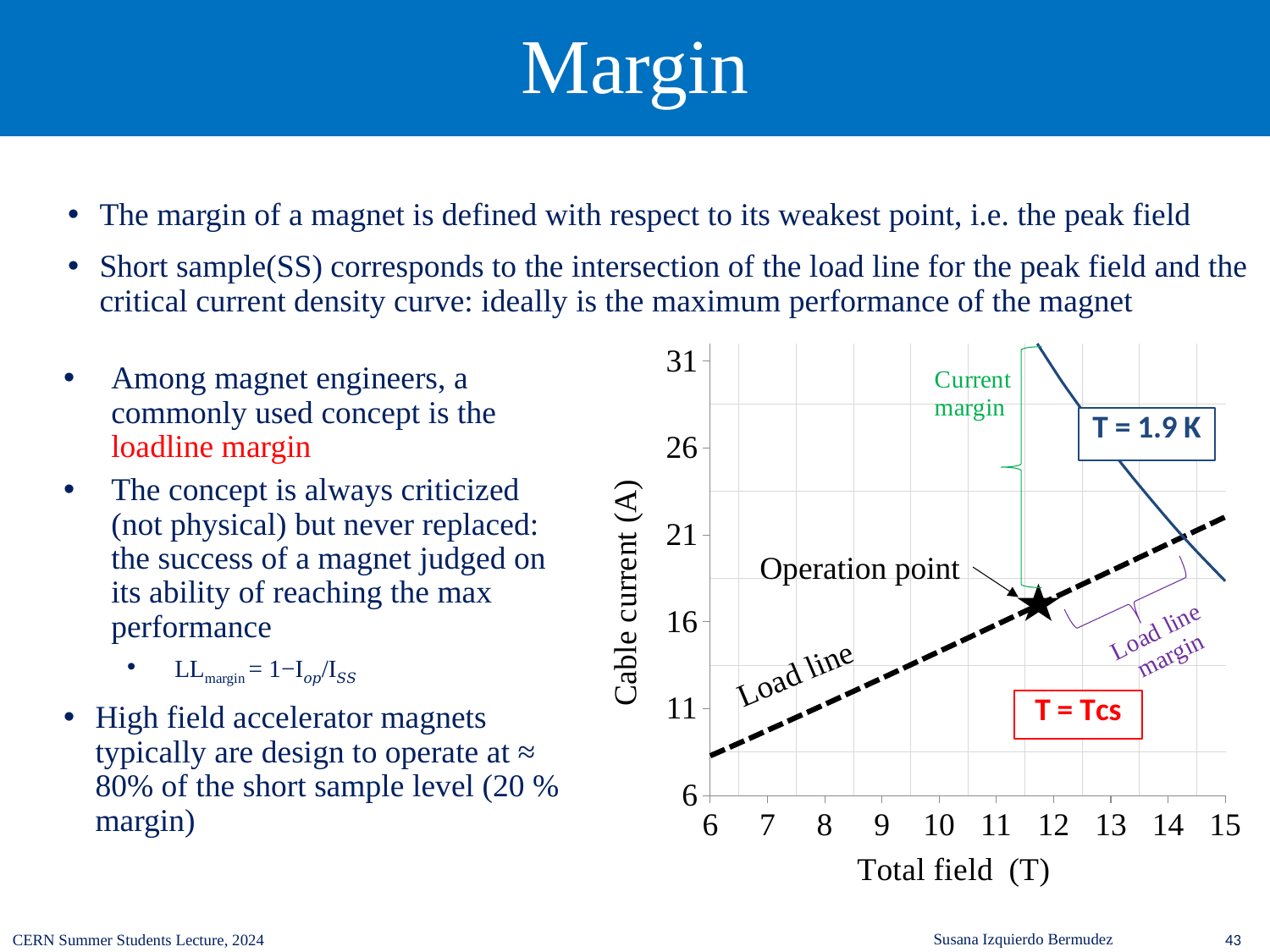
Is the cable current at the operation point greater or less than 11 A? greater Is the total field at the operation point greater or less than 11 T? greater What is the label of the x axis of the chart? Total field (T) Does the solid critical current curve labelled T = 1.9 K rise or fall as the total field increases? falls What is the label of the y axis of the chart? Cable current (A) Does the load line rise or fall as the total field increases? rises Is the cable current at the point where the load line meets the solid curve greater or less than 16 A? greater What kind of chart is shown on the slide? line chart How many tick labels are shown on the x axis of the chart? 10 What is the highest tick value shown on the y axis of the chart? 31